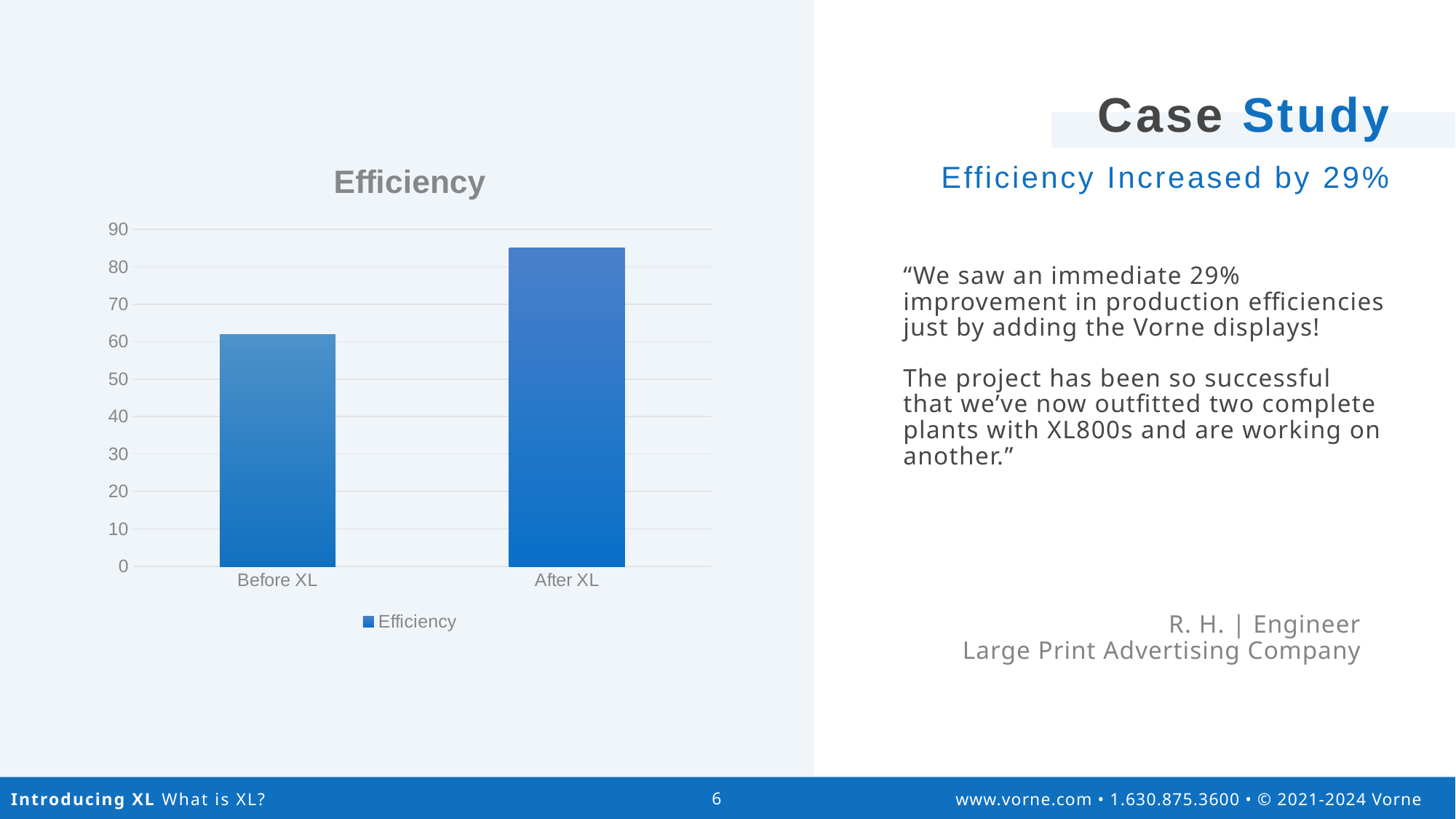
What is the title of the chart? Efficiency What kind of chart is shown on the slide? bar chart Do the values rise or fall from Before XL to After XL? rise Which is larger, the value for Before XL or the value for After XL? After XL How many categories are shown on the x axis of the chart? 2 Is the value for Before XL greater or less than 70? less Which category has the highest bar in the chart? After XL What series name appears in the chart legend? Efficiency How many series does the chart legend list? 1 Which category has the lowest bar in the chart? Before XL Is the value for After XL greater or less than 80? greater Is the value for After XL greater or less than 90? less